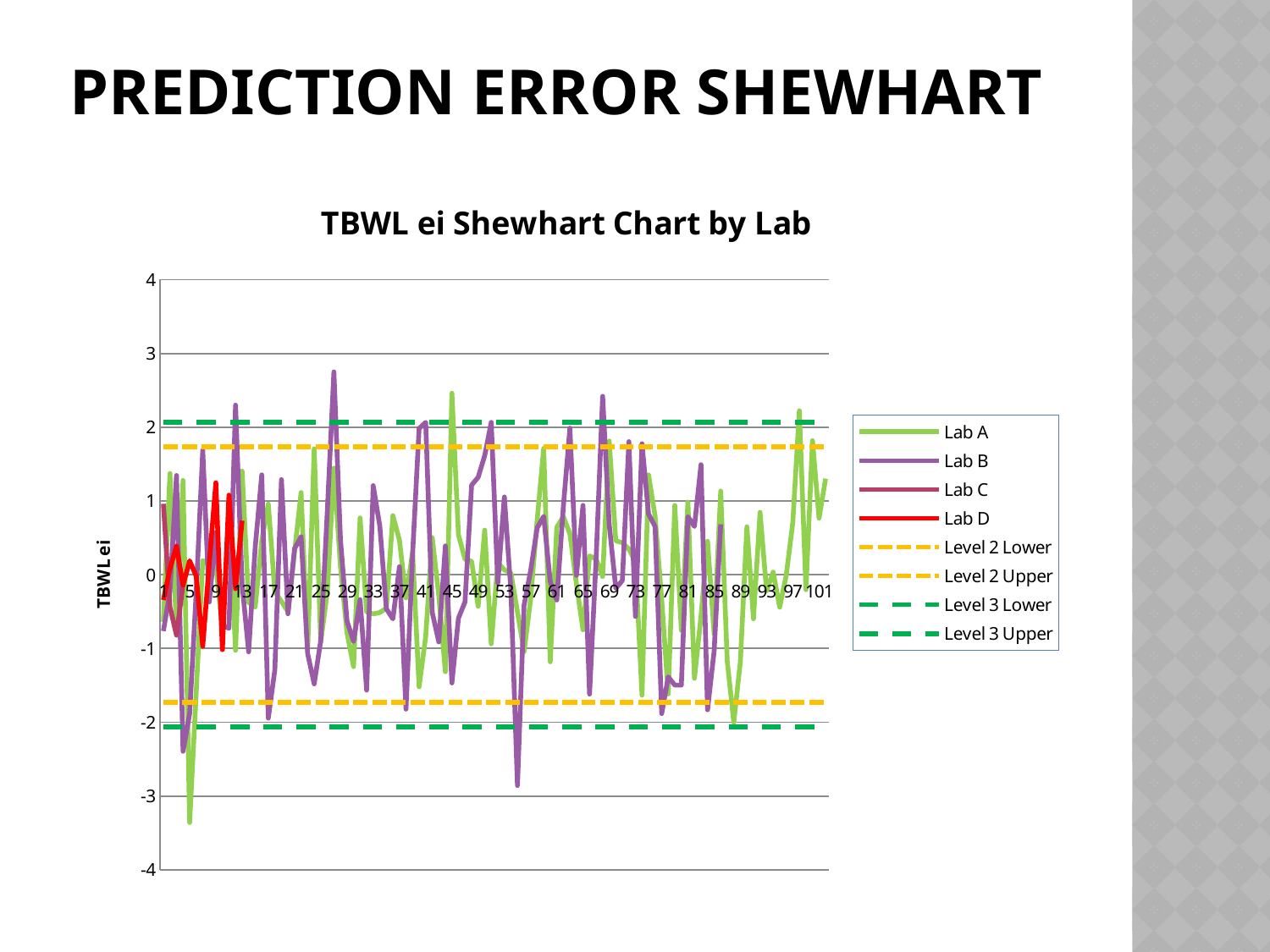
Which series is drawn in red in the legend? Lab D Is the Level 3 Upper line greater or less than 1? greater Is the highest value of the Lab B series greater or less than 2? greater Is the Level 2 Lower line greater or less than -1 on the y axis? less What is the title of the chart? TBWL ei Shewhart Chart by Lab What kind of chart is shown on the slide? line chart How many series does the legend list? 8